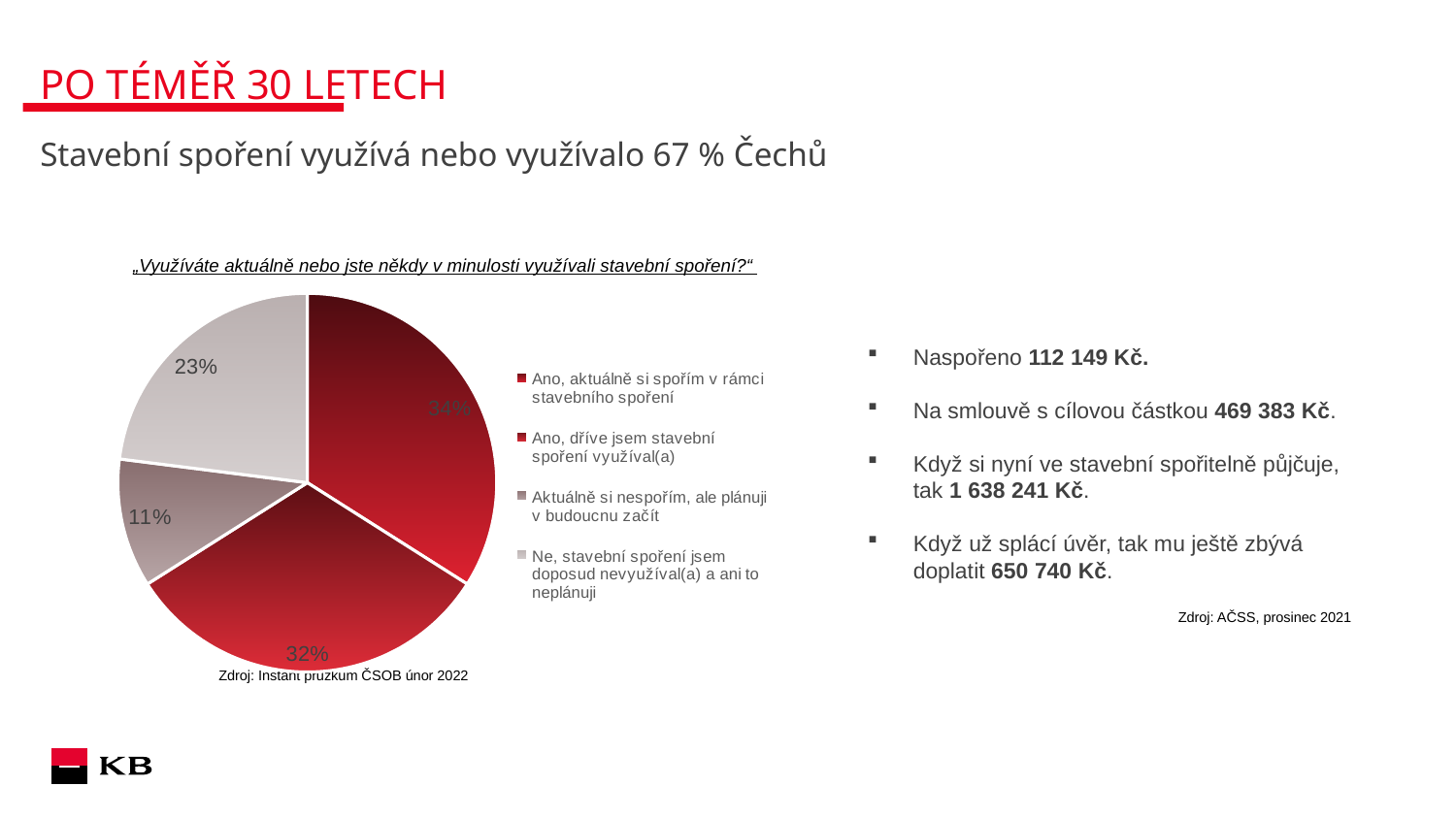
What is the difference in percentage points between the "Ne, stavební spoření jsem doposud nevyužíval(a) a ani to neplánuji" slice and the "Aktuálně si nespořím, ale plánuji v budoucnu začít" slice? 12 percentage points How many entries does the legend of the pie chart list? 4 What percentage of respondents answered "Aktuálně si nespořím, ale plánuji v budoucnu začít"? 11% What percentage of respondents answered "Ne, stavební spoření jsem doposud nevyužíval(a) a ani to neplánuji"? 23% What percentage of respondents answered "Ano, dříve jsem stavební spoření využíval(a)"? 32% Which is larger: the share for "Ano, dříve jsem stavební spoření využíval(a)" or the share for "Ne, stavební spoření jsem doposud nevyužíval(a) a ani to neplánuji"? Ano, dříve jsem stavební spoření využíval(a) How many slices does the pie chart have? 4 What kind of chart is shown on the slide? pie chart What survey question is shown above the pie chart? „Využíváte aktuálně nebo jste někdy v minulosti využívali stavební spoření?“ Which answer has the smallest share of the pie? Aktuálně si nespořím, ale plánuji v budoucnu začít Which answer has the largest share of the pie? Ano, aktuálně si spořím v rámci stavebního spoření What percentage of respondents answered "Ano, aktuálně si spořím v rámci stavebního spoření"? 34%